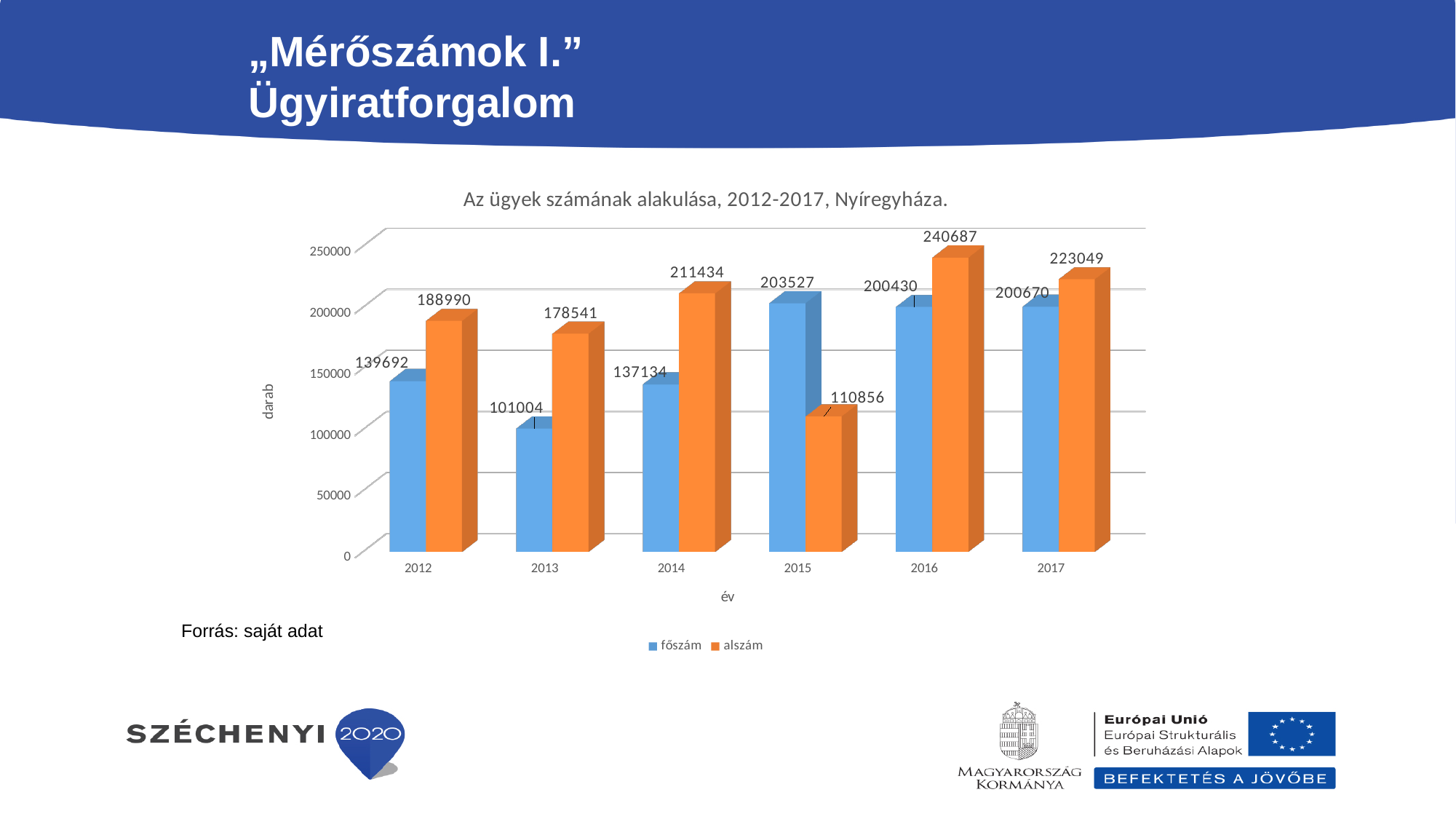
What kind of chart is shown on the slide? bar chart How many years are shown on the x axis? 6 What is the difference between the alszám and főszám values in 2016? 40257 Is the főszám value for 2013 greater or less than 150000? less What is the title of the chart? Az ügyek számának alakulása, 2012-2017, Nyíregyháza. Which is larger in 2012, főszám or alszám? alszám In which year is the alszám value lowest? 2015 What is the főszám value for 2015? 203527 What is the alszám value for 2013? 178541 How many series does the legend list? 2 In which year is the alszám value highest? 2016 In which year is the főszám value lowest? 2013